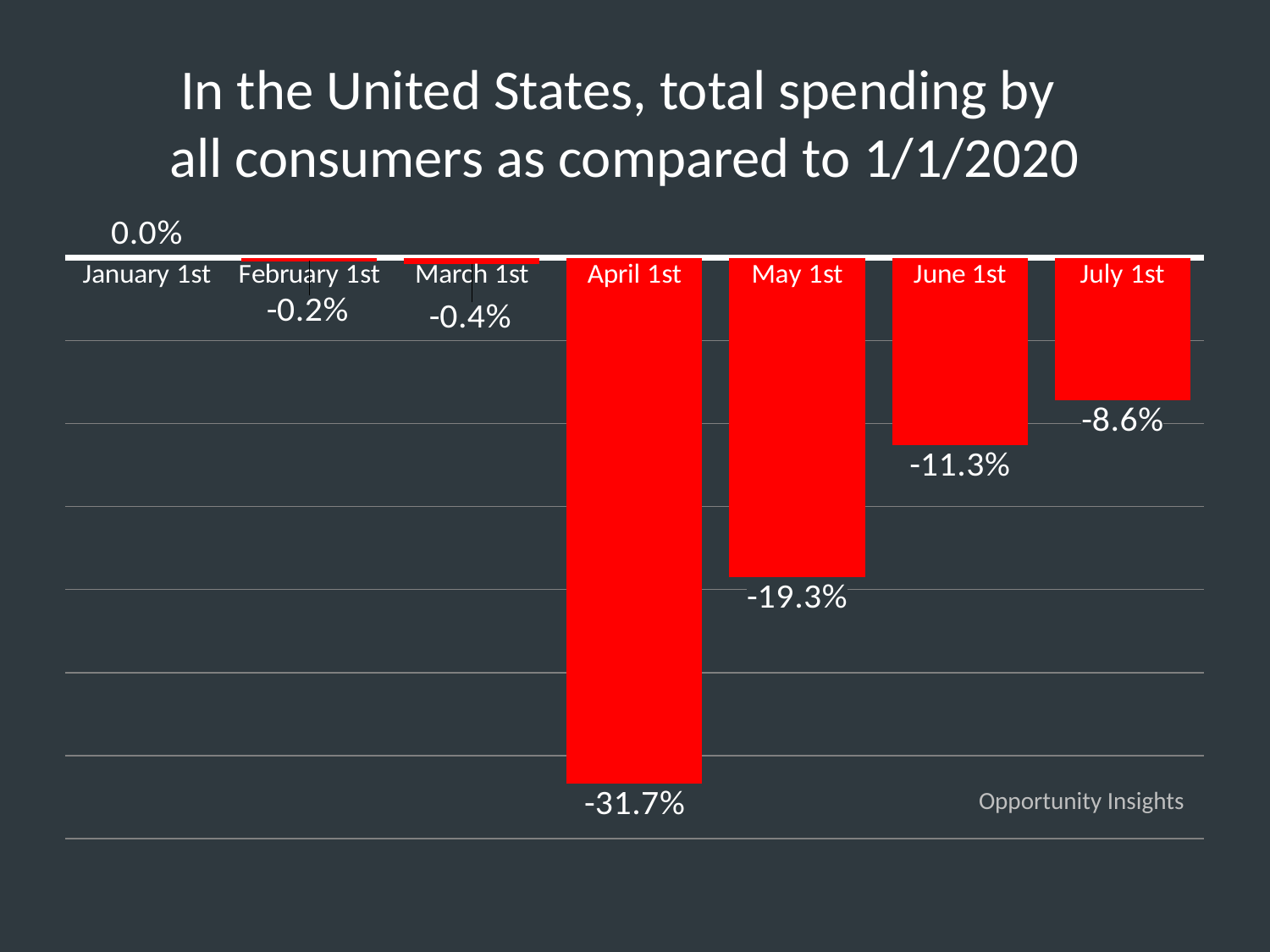
What is the value for February 1st? -0.2% What source is credited in the bottom right of the chart? Opportunity Insights What is the difference between the values for April 1st and May 1st? 12.4% What is the value for June 1st? -11.3% Which date has the lowest value? April 1st How many dates are shown on the x axis? 7 What kind of chart is this? Bar chart Which date has the highest value? January 1st What is the value for July 1st? -8.6% Which is larger, the value for May 1st or the value for June 1st? June 1st What is the value for April 1st? -31.7% What is the difference between the values for June 1st and July 1st? 2.7%